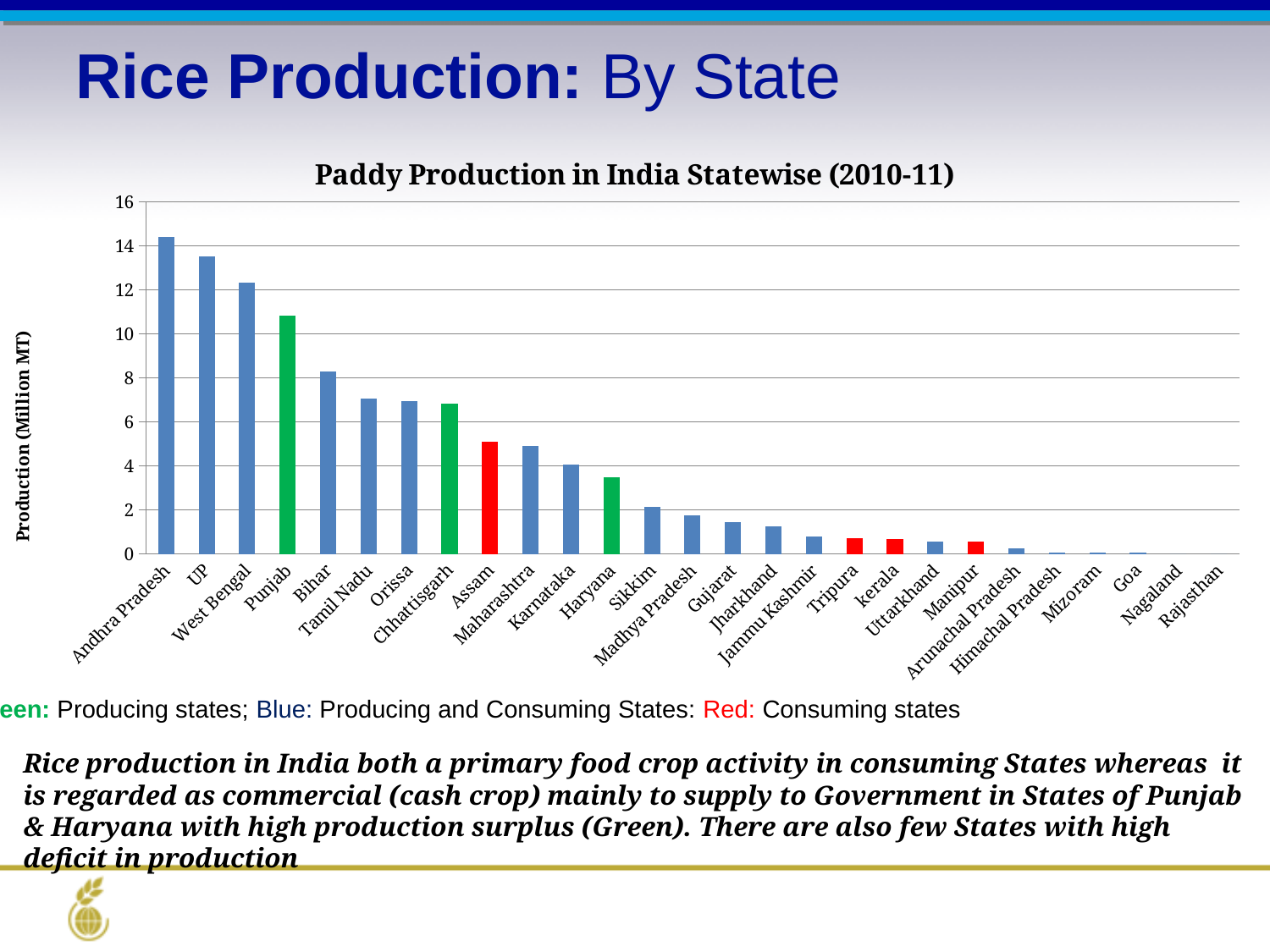
Do the values rise or fall moving from left to right along the x axis? Fall How many states are shown on the x axis of the chart? 27 Is the value for Haryana greater or less than 4? less Which has a higher paddy production, Punjab or Bihar? Punjab Which has a higher paddy production, Assam or Haryana? Assam Is the value for Tamil Nadu greater or less than 6? greater Which state has the highest paddy production in the chart? Andhra Pradesh Is the value for UP greater or less than 12? greater What is the title of the chart? Paddy Production in India Statewise (2010-11) What type of chart is shown on the slide? Bar chart